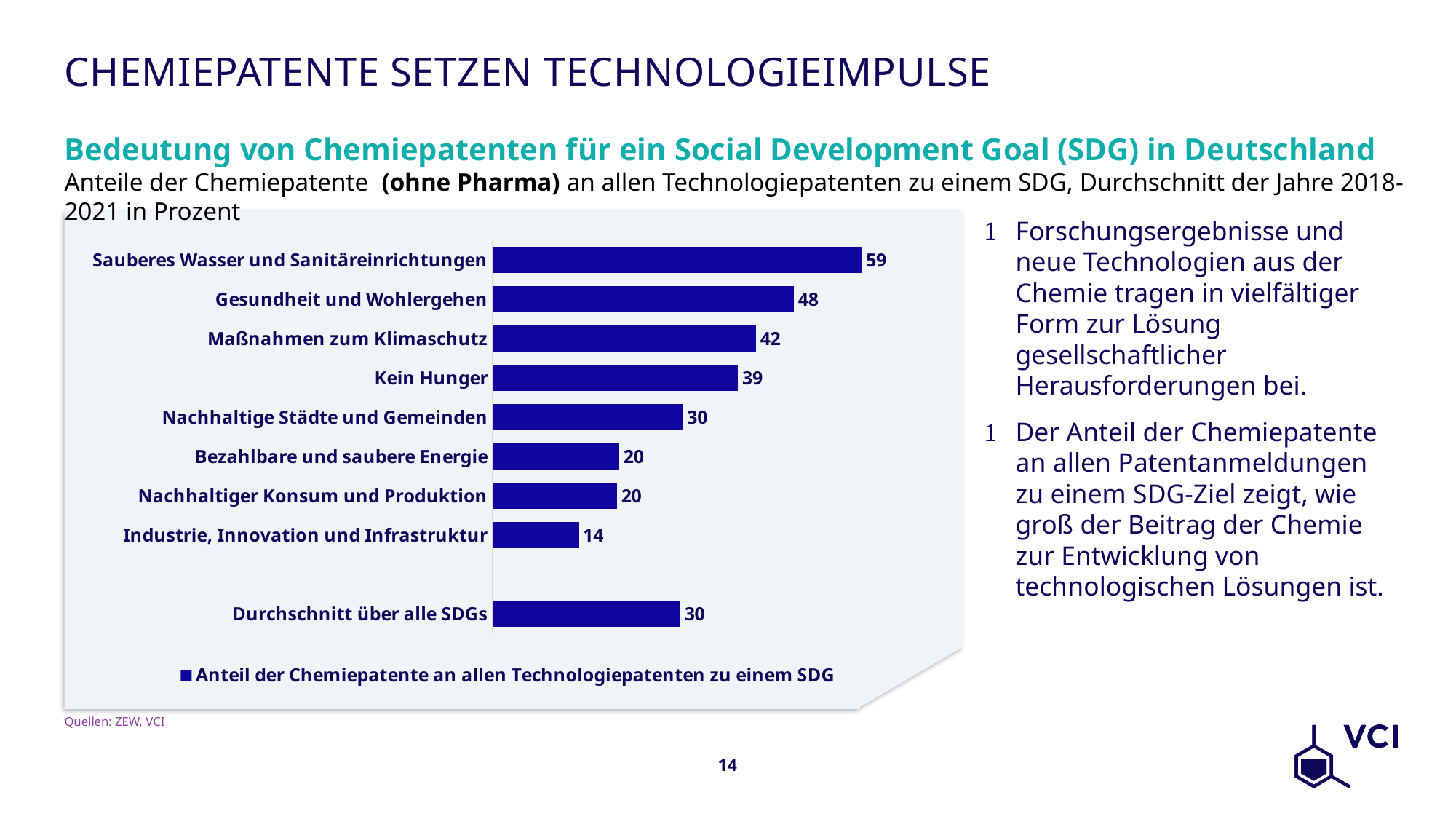
What is the difference between the values for Gesundheit und Wohlergehen and Maßnahmen zum Klimaschutz? 6 What is the value for Kein Hunger? 39 How many series does the legend list? 1 What is the difference between the value for Sauberes Wasser und Sanitäreinrichtungen and the value for Industrie, Innovation und Infrastruktur? 45 Which is larger, the value for Nachhaltige Städte und Gemeinden or the value for Bezahlbare und saubere Energie? Nachhaltige Städte und Gemeinden Which category has the highest value? Sauberes Wasser und Sanitäreinrichtungen Which category has the lowest value? Industrie, Innovation und Infrastruktur What kind of chart is shown on the slide? Bar chart What is the value for Durchschnitt über alle SDGs? 30 What is the legend entry of the chart? Anteil der Chemiepatente an allen Technologiepatenten zu einem SDG What is the value for Sauberes Wasser und Sanitäreinrichtungen? 59 How many bars are shown in the chart? 9